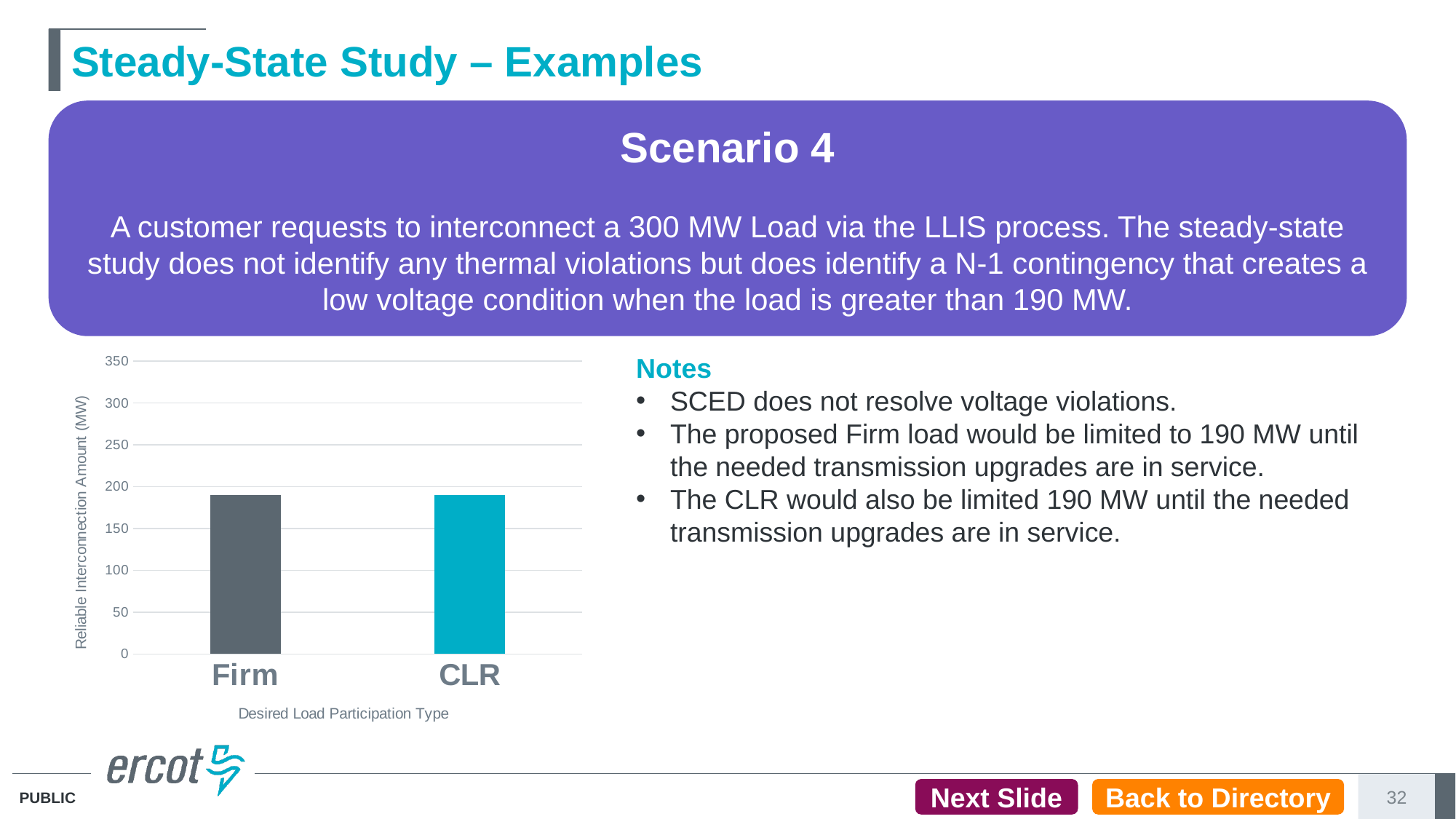
What is the title of the y axis of the chart? Reliable Interconnection Amount (MW) What kind of chart is shown on the slide? bar chart Is the value for Firm greater or less than 200? less Is the value for Firm greater or less than 150? greater Is the value for CLR greater or less than 150? greater What is the title of the x axis of the chart? Desired Load Participation Type What is the highest value shown on the y axis of the chart? 350 How many categories are shown on the x axis of the chart? 2